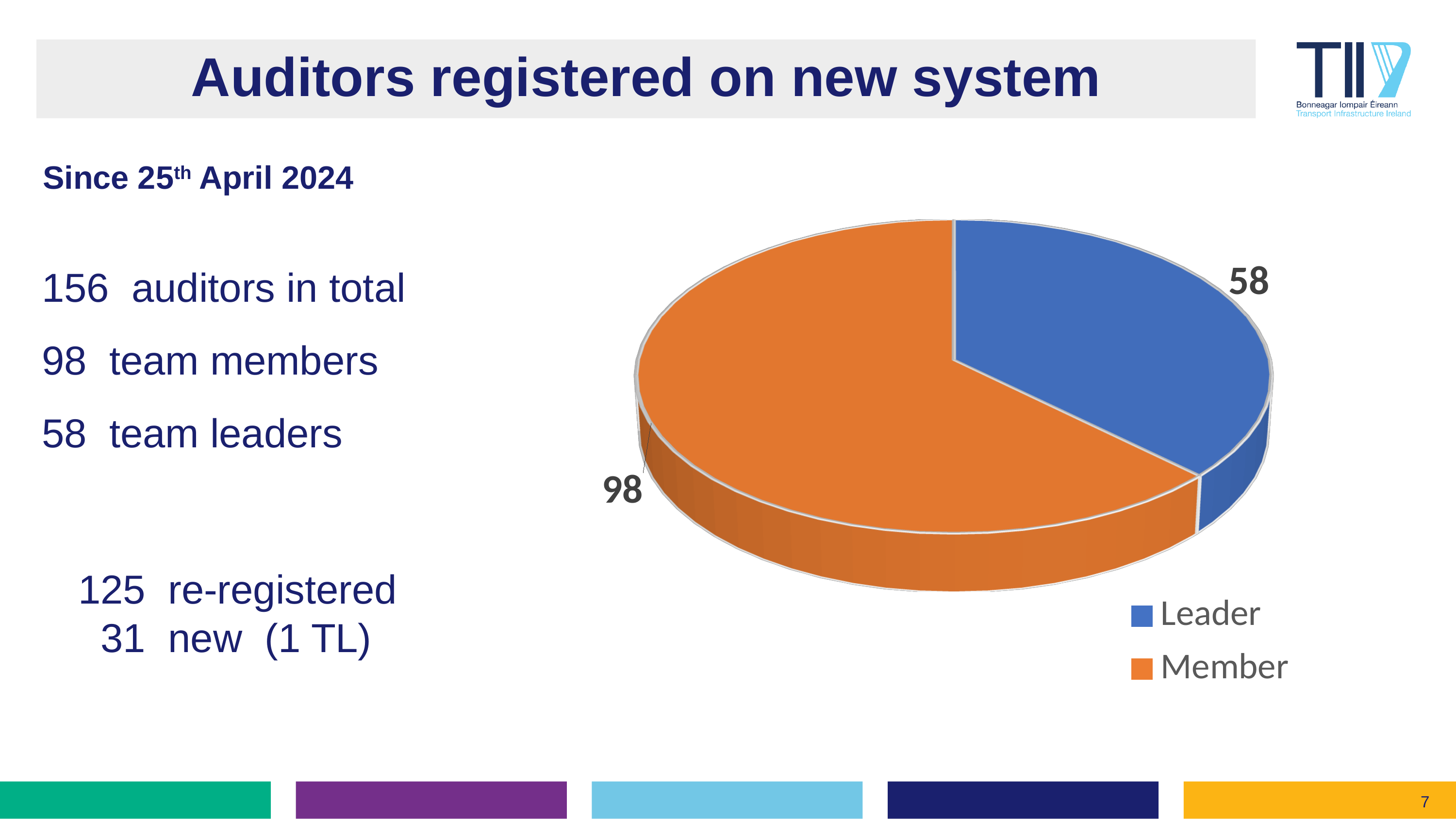
What is the value for Leader in the pie chart? 58 What is the difference between the Member and Leader values in the pie chart? 40 Which category has the smallest slice in the pie chart? Leader What is the total of the two slices in the pie chart? 156 Which is larger in the pie chart, Leader or Member? Member What colour is the Leader slice in the pie chart? blue What is the value for Member in the pie chart? 98 How many slices does the pie chart have? 2 Which category has the largest slice in the pie chart? Member What type of chart is shown on the slide? pie chart What share of the pie chart does the Member slice represent, to the nearest whole percent? 63% How many entries does the legend of the pie chart list? 2